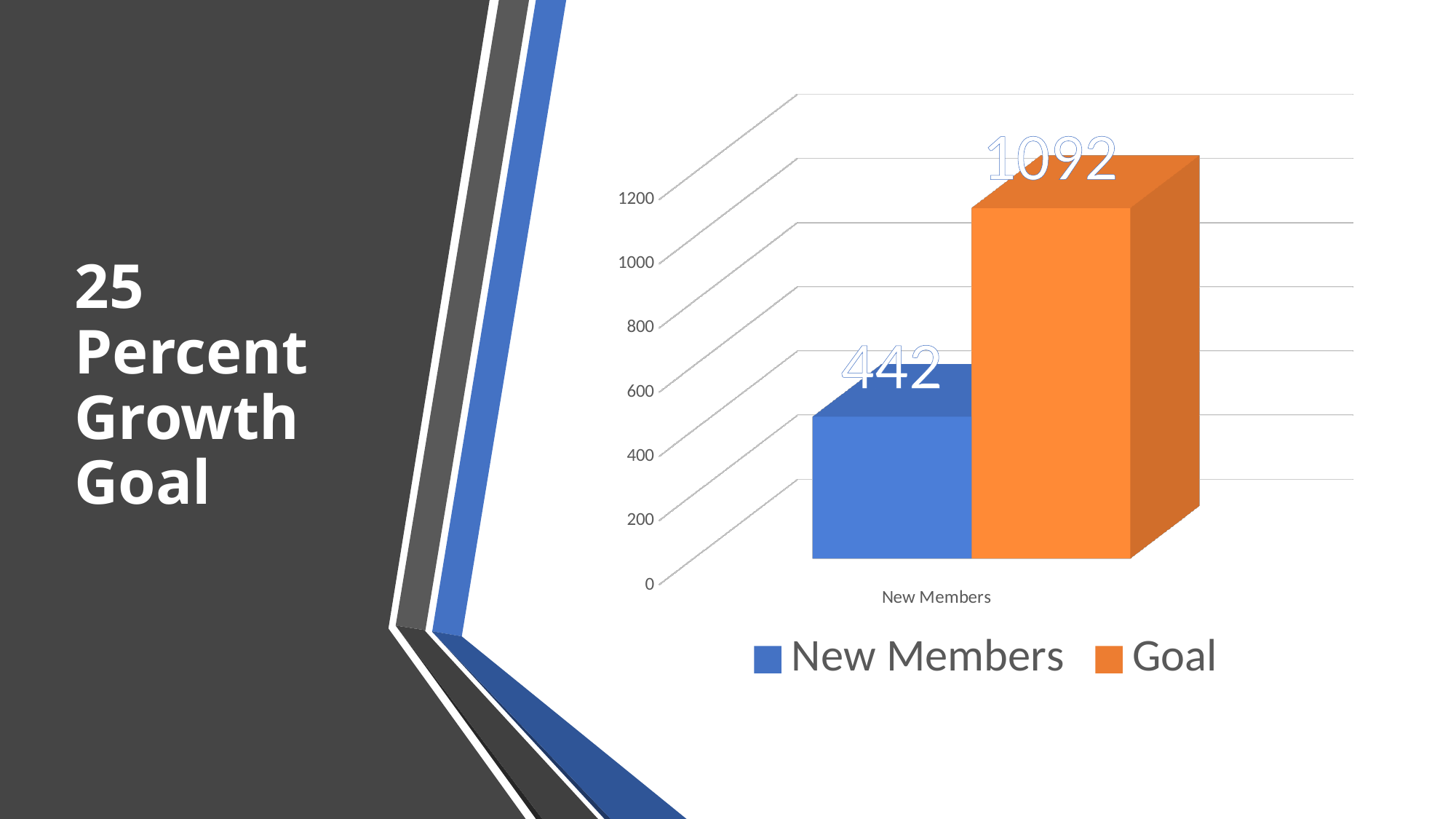
Which series has the lowest value? New Members What is the difference between the Goal value and the New Members value? 650 Is the value for Goal greater or less than 1000? greater How many series does the legend list? 2 What colour is the Goal bar? Orange What is the value of the New Members bar? 442 What is the highest value labelled on the vertical axis? 1200 What kind of chart is shown on the slide? Bar chart Is the value for New Members greater or less than 600? less Which series has the higher value, New Members or Goal? Goal What is the value of the Goal bar? 1092 What is the category label on the x axis? New Members